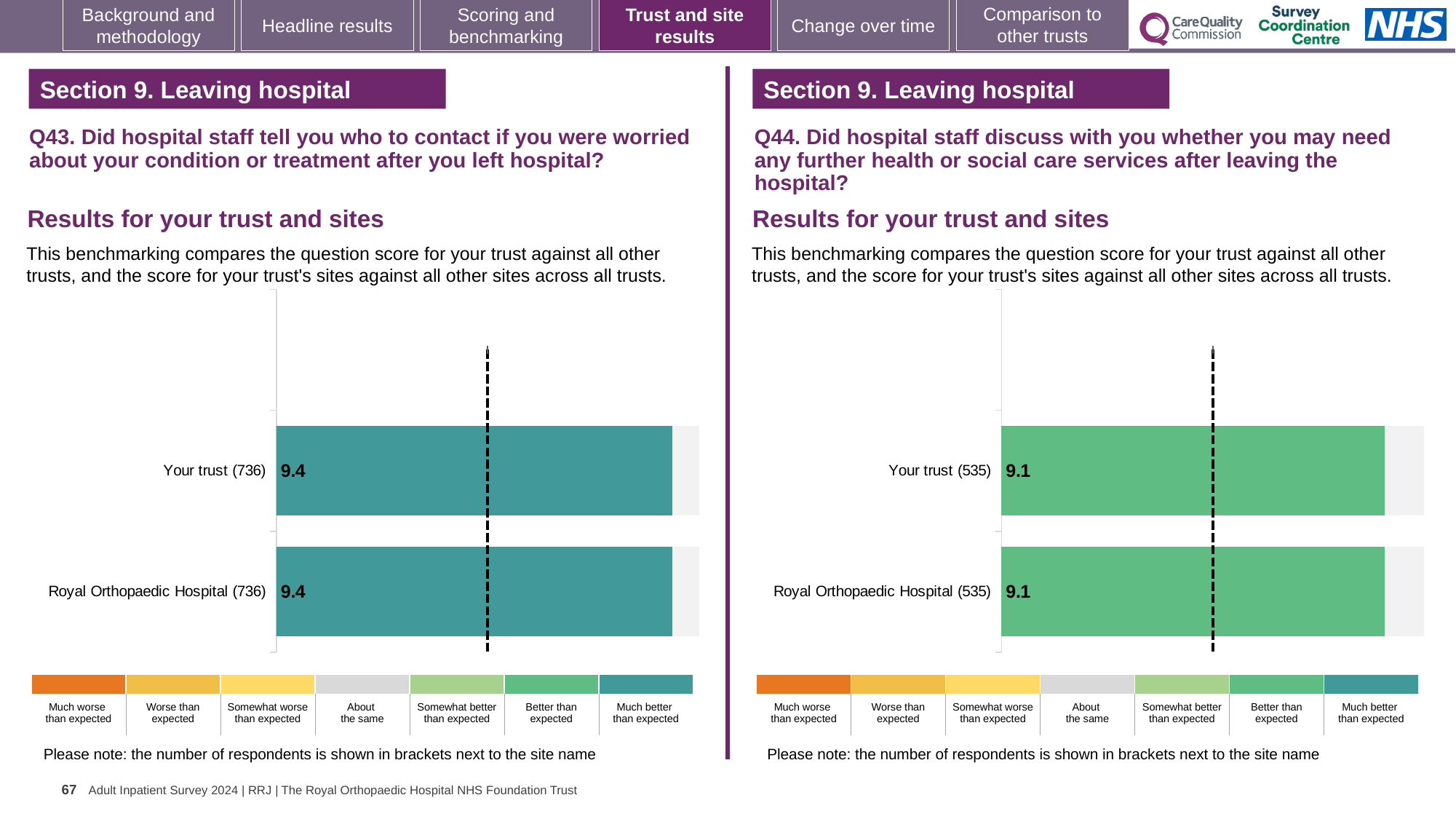
In the Q44 chart on the right, how many bars are plotted? 2 In the Q44 chart on the right, what is the score for Your trust? 9.1 In the Q43 chart on the left, how many respondents are shown in brackets next to Your trust? 736 Which is larger: the Your trust score in the Q43 chart on the left or the Your trust score in the Q44 chart on the right? Q43 (9.4) In the Q44 chart on the right, what is the score for Royal Orthopaedic Hospital? 9.1 In the Q43 chart on the left, how many bars are plotted? 2 In the Q43 chart on the left, what is the difference between the score for Your trust and the score for Royal Orthopaedic Hospital? 0 In the Q43 chart on the left, what is the score for Royal Orthopaedic Hospital? 9.4 In the Q44 chart on the right, how many respondents are shown in brackets next to Royal Orthopaedic Hospital? 535 What is the difference between the Your trust score in the Q43 chart on the left and the Your trust score in the Q44 chart on the right? 0.3 What kind of chart is used in the Q43 chart on the left? Bar chart In the Q43 chart on the left, what is the score for Your trust? 9.4